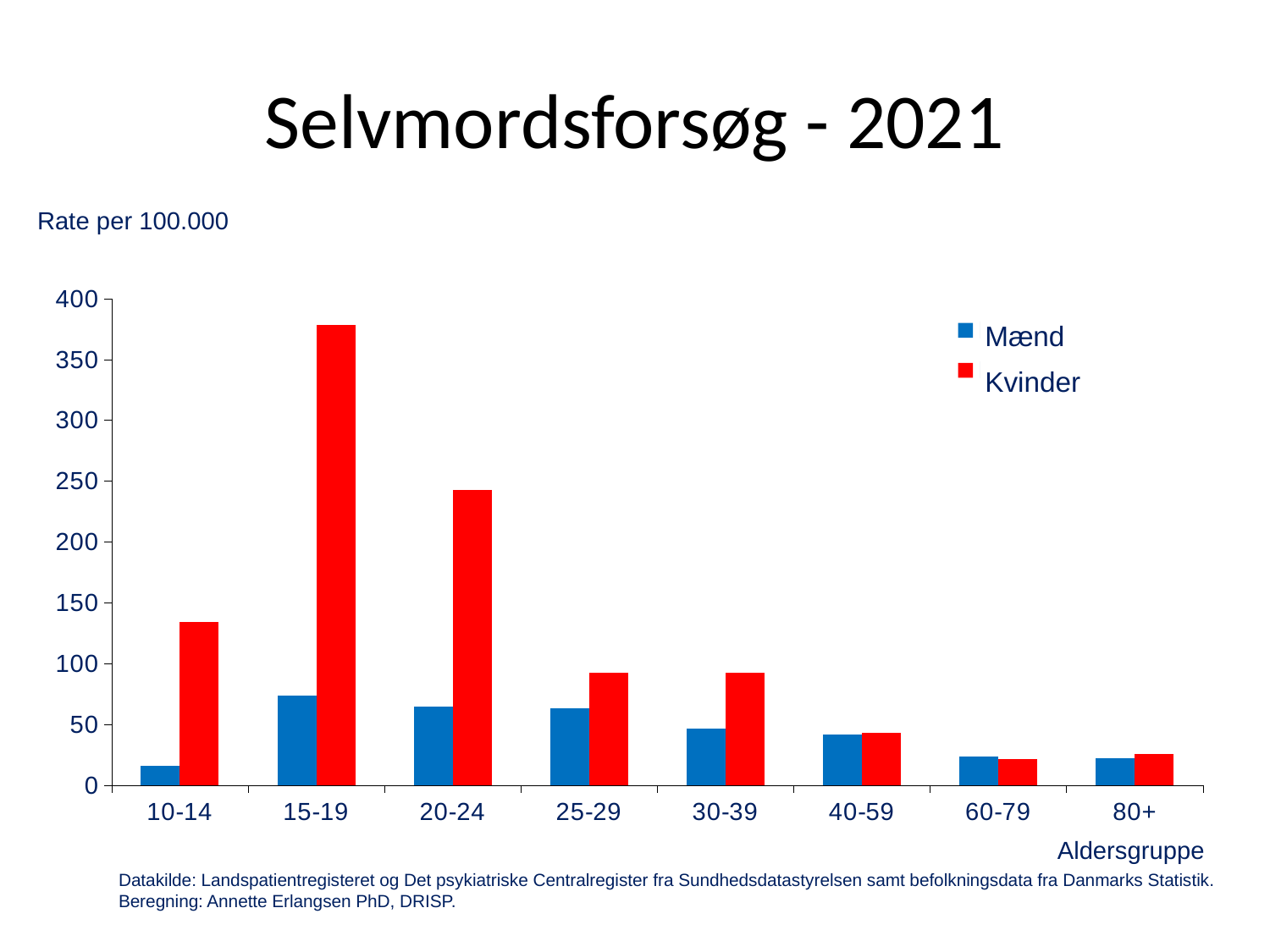
In the 10-14 age group, which series has the larger value, Mænd or Kvinder? Kvinder What is the title of the chart? Selvmordsforsøg - 2021 Is the value for Mænd in the 10-14 age group greater or less than 50? less From the 20-24 age group to the 60-79 age group, do the Kvinder values rise or fall? fall Which age group has the lowest rate for Mænd? 10-14 Which age group has the highest rate for Kvinder? 15-19 How many series does the legend list? 2 What type of chart is shown on the slide? bar chart Is the value for Kvinder in the 15-19 age group greater or less than 350? greater Which age group has the highest rate for Mænd? 15-19 How many age groups are shown on the x axis? 8 Is the value for Kvinder in the 20-24 age group greater or less than 200? greater